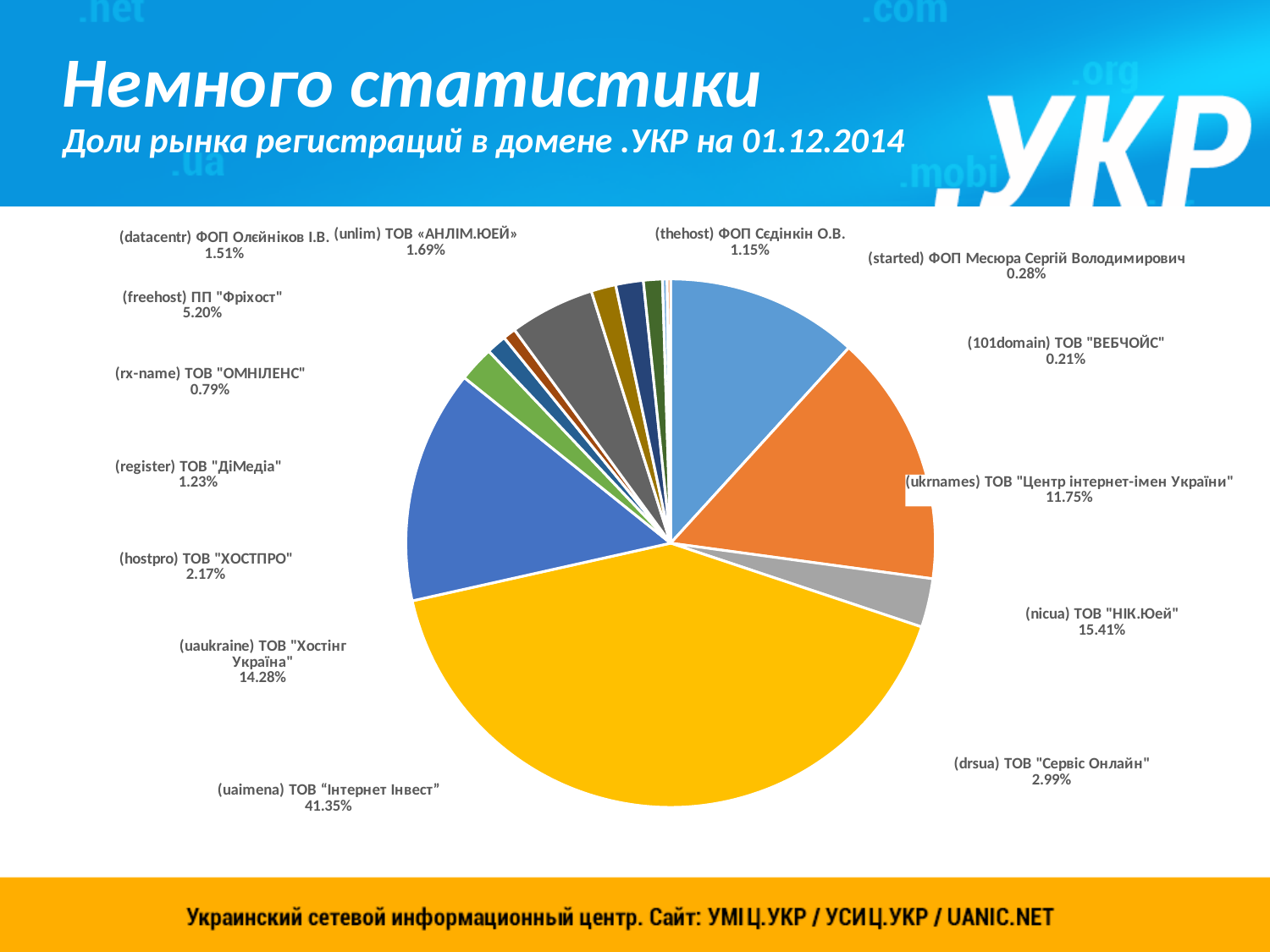
Which registrar has the smallest share of the pie? (101domain) ТОВ "ВЕБЧОЙС" What kind of chart is shown on the slide? pie chart What is the value shown for (started) ФОП Месюра Сергій Володимирович? 0.28% Which registrar has the largest share of the pie? (uaimena) ТОВ "Інтернет Інвест" How many registrars (slices) are shown in the pie chart? 14 What is the value shown for (freehost) ПП "Фріхост"? 5.20% What date does the chart subtitle say the market shares are for? 01.12.2014 What is the value shown for (ukrnames) ТОВ "Центр інтернет-імен України"? 11.75% Which has the larger share: (drsua) ТОВ "Сервіс Онлайн" or (hostpro) ТОВ "ХОСТПРО"? (drsua) ТОВ "Сервіс Онлайн" What share of the pie does (uaimena) ТОВ "Інтернет Інвест" hold? 41.35% What is the value shown for (nicua) ТОВ "НІК.Юей"? 15.41% What is the difference between the shares of (nicua) ТОВ "НІК.Юей" and (uaukraine) ТОВ "Хостінг Україна"? 1.13%